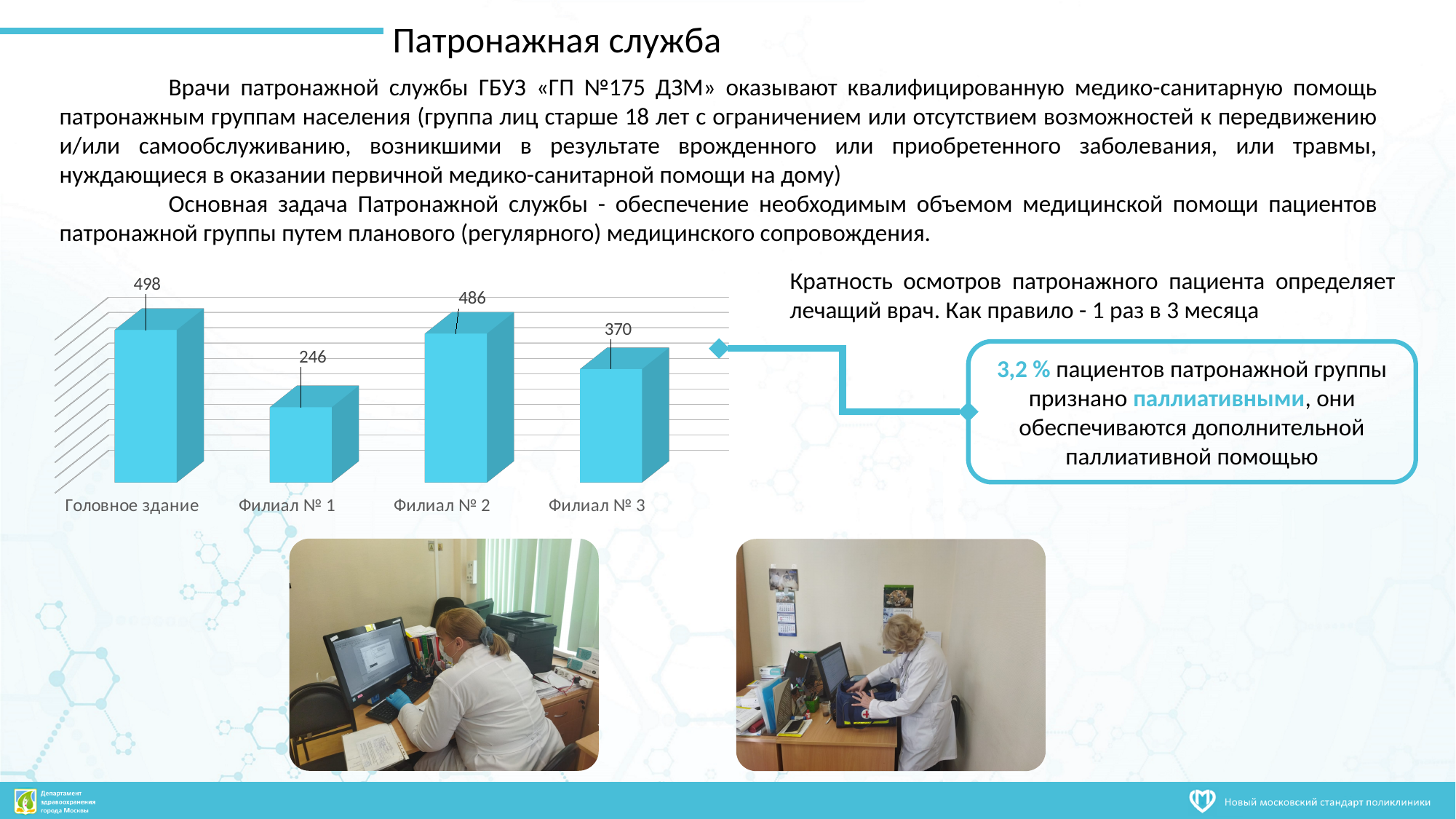
What is the difference between the values for Филиал № 2 and Филиал № 3? 116 What is the value for Головное здание? 498 Which is larger, the value for Филиал № 3 or the value for Филиал № 1? Филиал № 3 Which category has the lowest value? Филиал № 1 Which category has the highest value? Головное здание What kind of chart is shown on the slide? Bar chart What is the total of the values for all four categories in the chart? 1600 What is the value for Филиал № 1? 246 What is the difference between the values for Головное здание and Филиал № 1? 252 How many categories are shown in the chart? 4 What is the value for Филиал № 2? 486 What is the value for Филиал № 3? 370